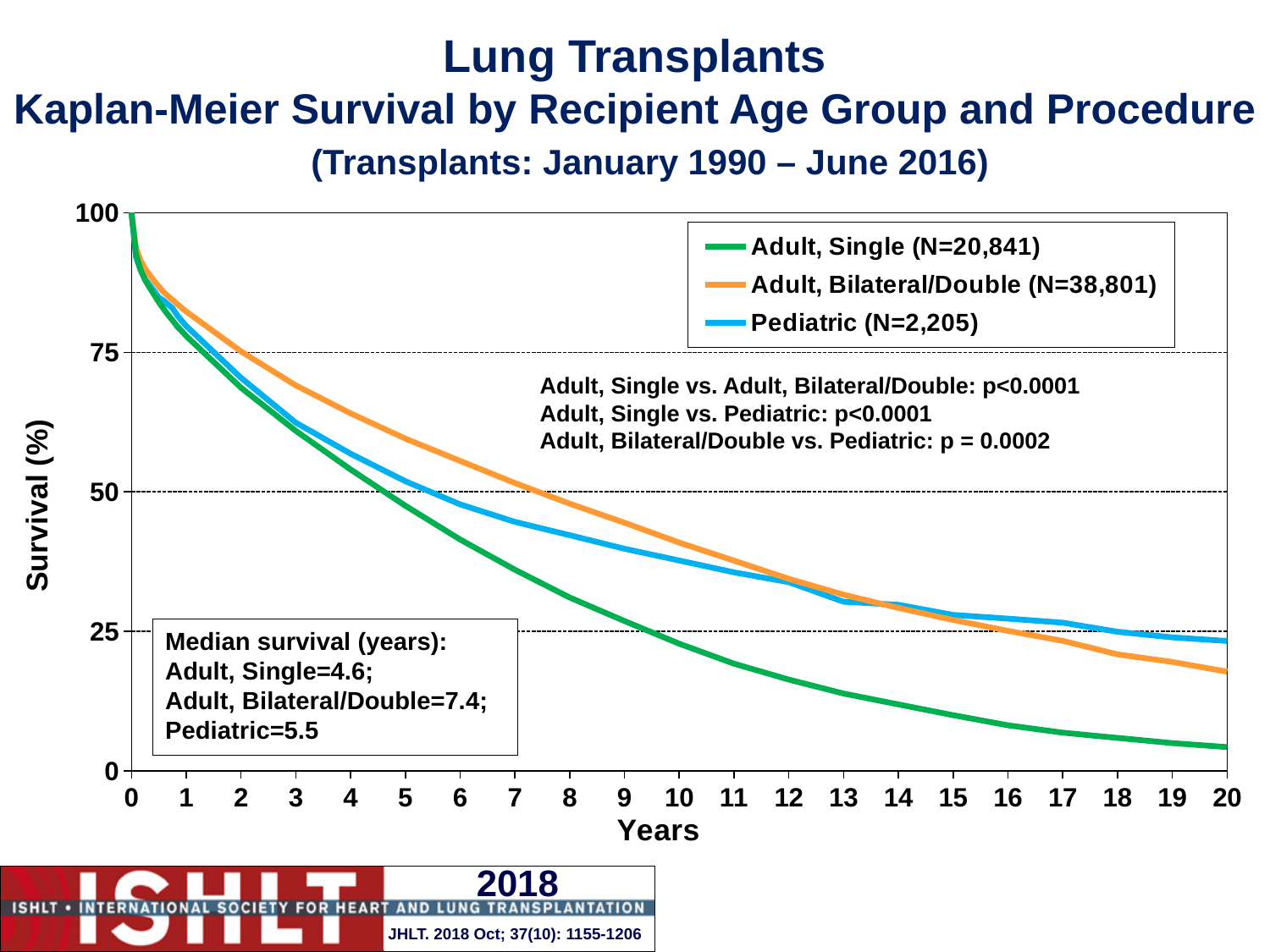
What is the N for the Pediatric group shown in the legend? N=2,205 How many series does the legend list? 3 Do the survival curves rise or fall as years increase? Fall At 5 years, which group has higher survival: Adult, Bilateral/Double or Pediatric? Adult, Bilateral/Double Is the survival for Adult, Bilateral/Double at 5 years greater or less than 50%? greater Is the survival for Adult, Single at 20 years greater or less than 25%? less What is the median survival in years for Pediatric recipients? 5.5 Which group has the highest median survival? Adult, Bilateral/Double What is the median survival in years for Adult, Bilateral/Double recipients? 7.4 What kind of chart is shown on the slide? Line chart What is the difference in median survival (years) between Adult, Bilateral/Double and Adult, Single? 2.8 Which group has the lowest median survival? Adult, Single